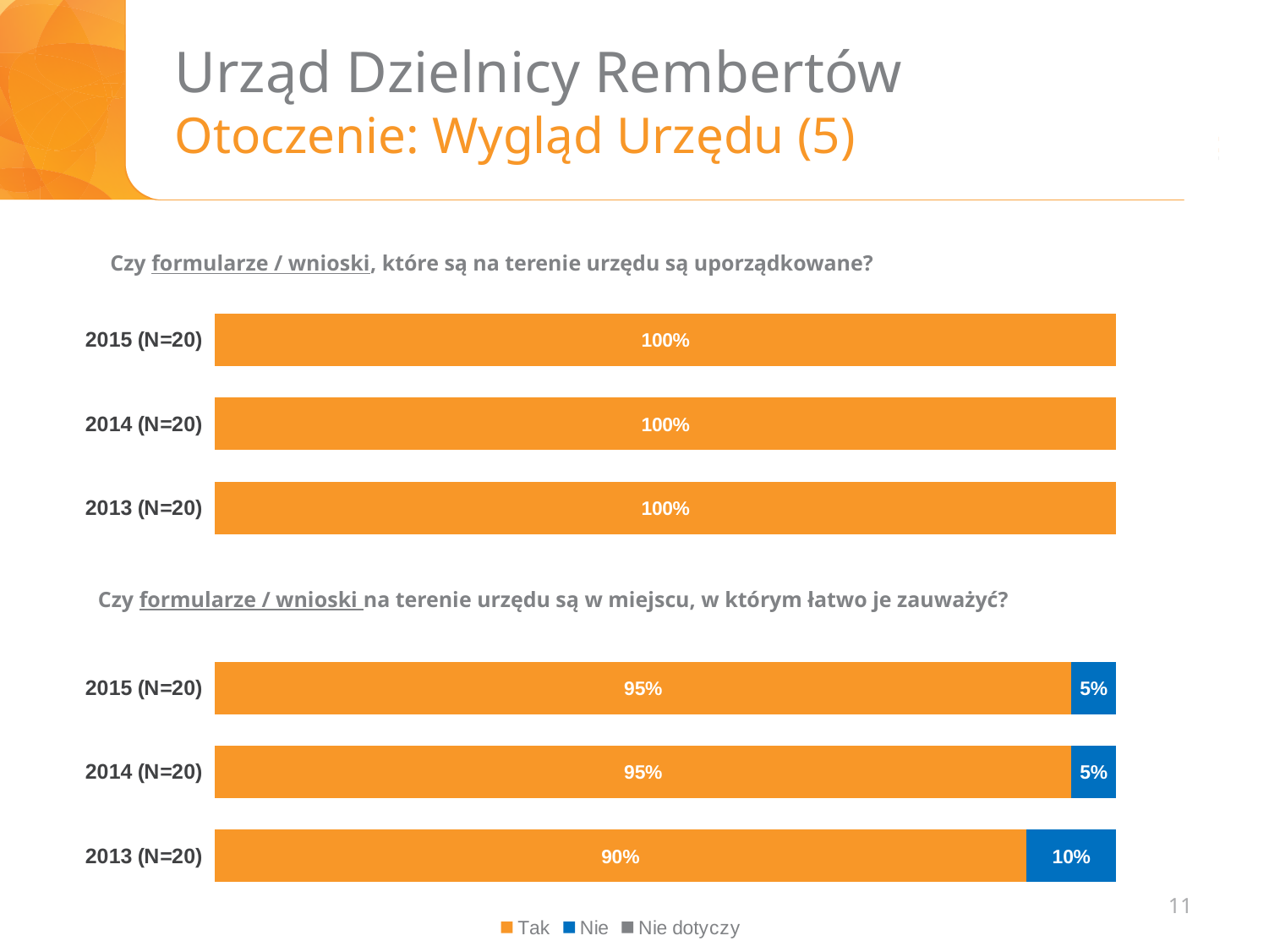
In the bottom chart ("Czy formularze / wnioski na terenie urzędu są w miejscu, w którym łatwo je zauważyć?"), what is the Nie value for 2015 (N=20)? 5% In the bottom chart ("Czy formularze / wnioski na terenie urzędu są w miejscu, w którym łatwo je zauważyć?"), which year has the lowest Tak value? 2013 (N=20) How many series does the legend at the bottom of the slide list? 3 In the bottom chart ("Czy formularze / wnioski na terenie urzędu są w miejscu, w którym łatwo je zauważyć?"), what is the Tak value for 2013 (N=20)? 90% In the top chart ("Czy formularze / wnioski, które są na terenie urzędu są uporządkowane?"), how many year categories are shown? 3 In the bottom chart ("Czy formularze / wnioski na terenie urzędu są w miejscu, w którym łatwo je zauważyć?"), what is the Nie value for 2013 (N=20)? 10% In the bottom chart ("Czy formularze / wnioski na terenie urzędu są w miejscu, w którym łatwo je zauważyć?"), what is the total of the stacked bar for 2013 (N=20)? 100% In the bottom chart ("Czy formularze / wnioski na terenie urzędu są w miejscu, w którym łatwo je zauważyć?"), is the Nie value for 2013 (N=20) larger or smaller than the Nie value for 2014 (N=20)? larger In the top chart ("Czy formularze / wnioski, które są na terenie urzędu są uporządkowane?"), what is the value shown for 2015 (N=20)? 100% In the bottom chart ("Czy formularze / wnioski na terenie urzędu są w miejscu, w którym łatwo je zauważyć?"), what is the difference between the Tak value for 2015 (N=20) and the Tak value for 2013 (N=20)? 5% In the top chart ("Czy formularze / wnioski, które są na terenie urzędu są uporządkowane?"), what is the value shown for 2013 (N=20)? 100% In the bottom chart ("Czy formularze / wnioski na terenie urzędu są w miejscu, w którym łatwo je zauważyć?"), which year has the highest Nie value? 2013 (N=20)